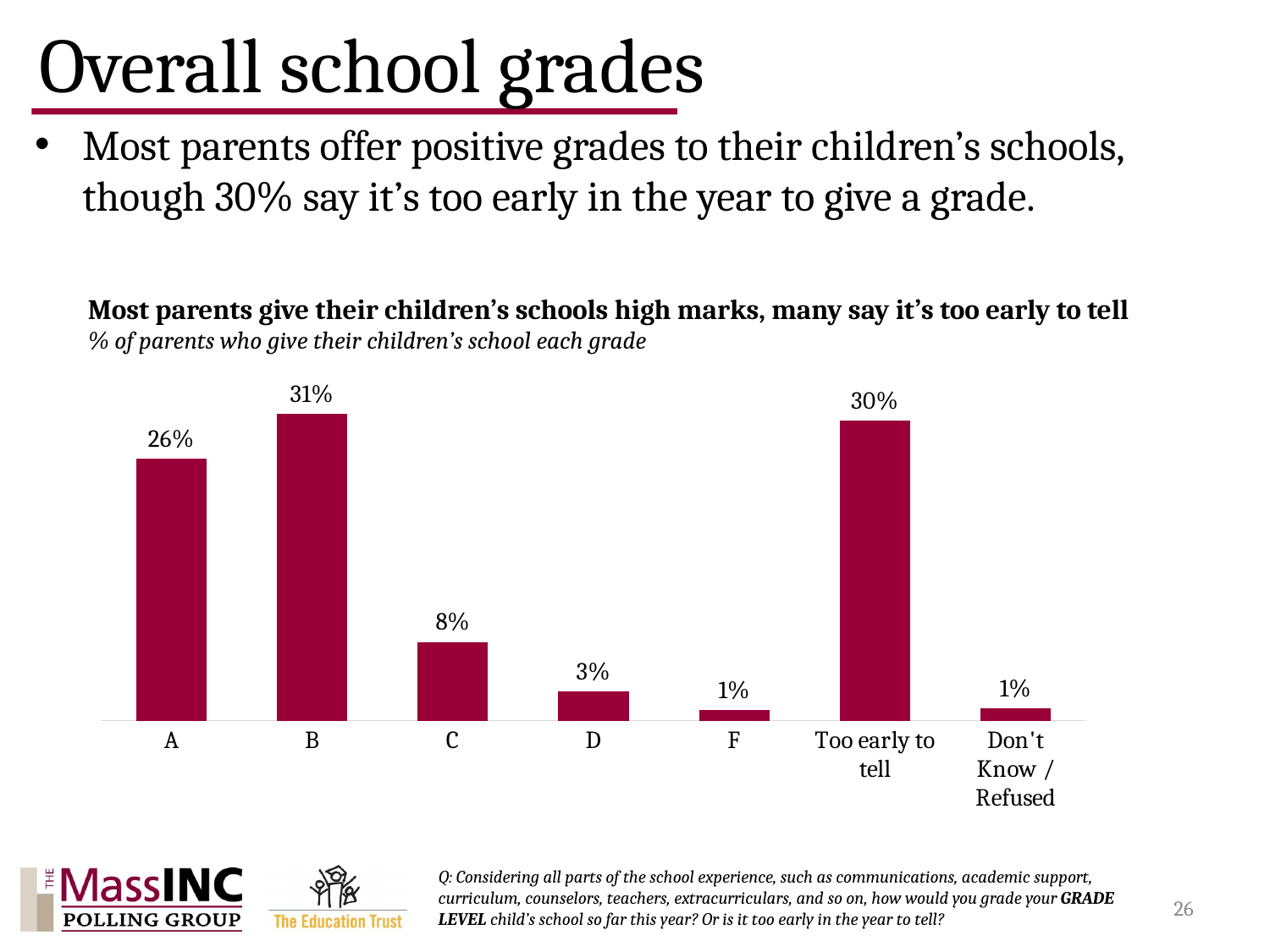
What percentage of parents say it is too early to tell? 30% What is the difference between the percentage giving a B and the percentage giving a D? 28% What is the title of the chart? Most parents give their children's schools high marks, many say it's too early to tell Which category has the highest value in the chart? B How many categories are shown on the x axis of the chart? 7 Which is larger: the percentage giving an A or the percentage saying it's too early to tell? Too early to tell What is the combined percentage of parents giving a grade of A or B? 57% What percentage of parents give their children's school a grade of C? 8% What percentage of parents answered Don't Know / Refused? 1% What kind of chart is shown on the slide? Bar chart What is the difference between the percentage giving a C and the percentage giving an F? 7% What percentage of parents give their children's school a grade of A? 26%